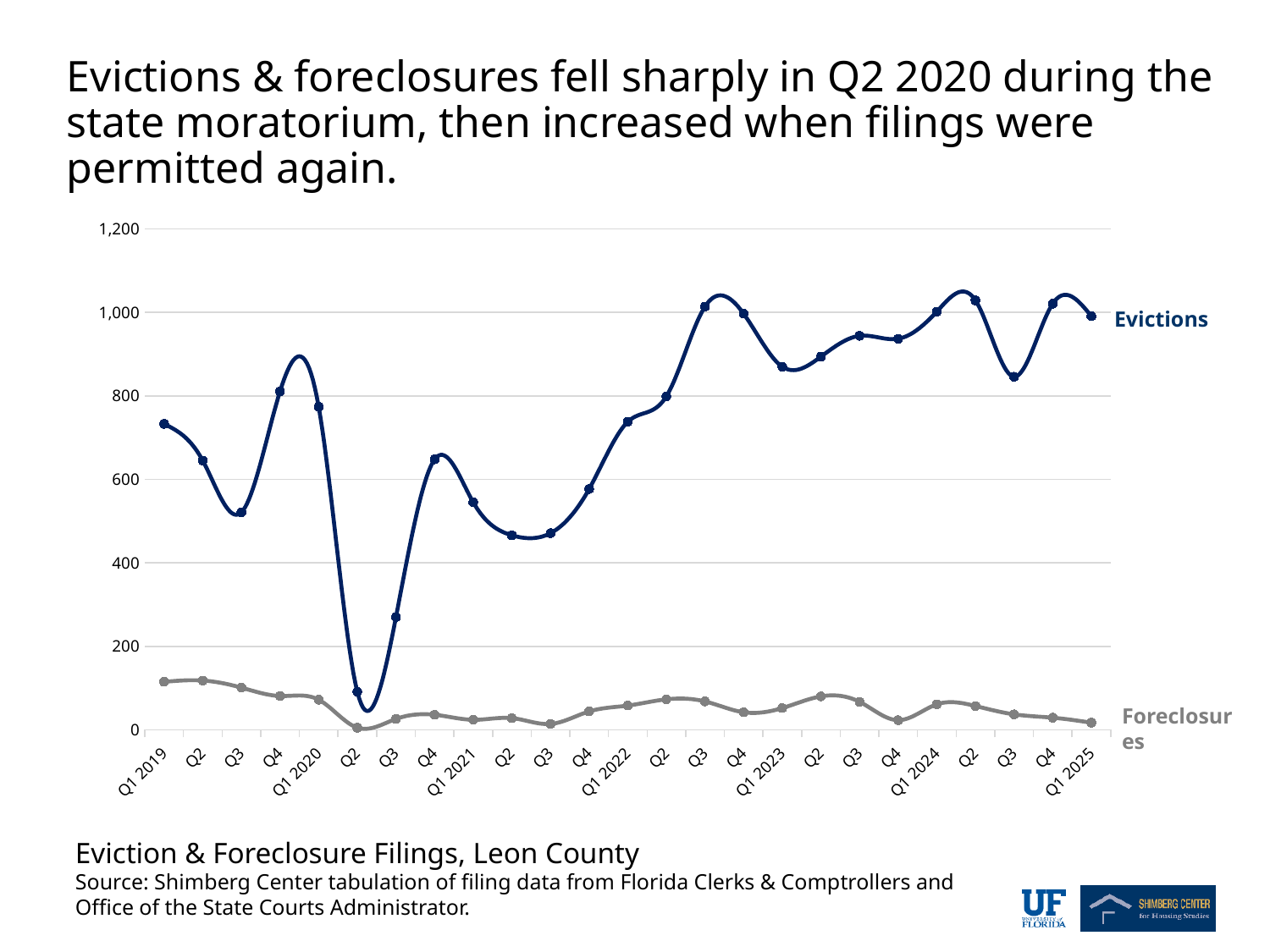
How many data series are plotted on the chart? 2 In which quarter is the Evictions series at its lowest? Q2 2020 Do Evictions rise or fall from Q2 2020 to Q4 2020? rise Which is larger, the Evictions value for Q1 2019 or for Q3 2019? Q1 2019 Is the Foreclosures value for Q1 2019 greater or less than 200? less What kind of chart is shown on the slide? line chart Is the Evictions value for Q2 2020 greater or less than 200? less Is the Evictions value for Q1 2019 greater or less than 600? greater How many quarters are plotted along the x axis of the chart? 25 Which series has the higher value in Q1 2025, Evictions or Foreclosures? Evictions What is the title of the chart given below it? Eviction & Foreclosure Filings, Leon County